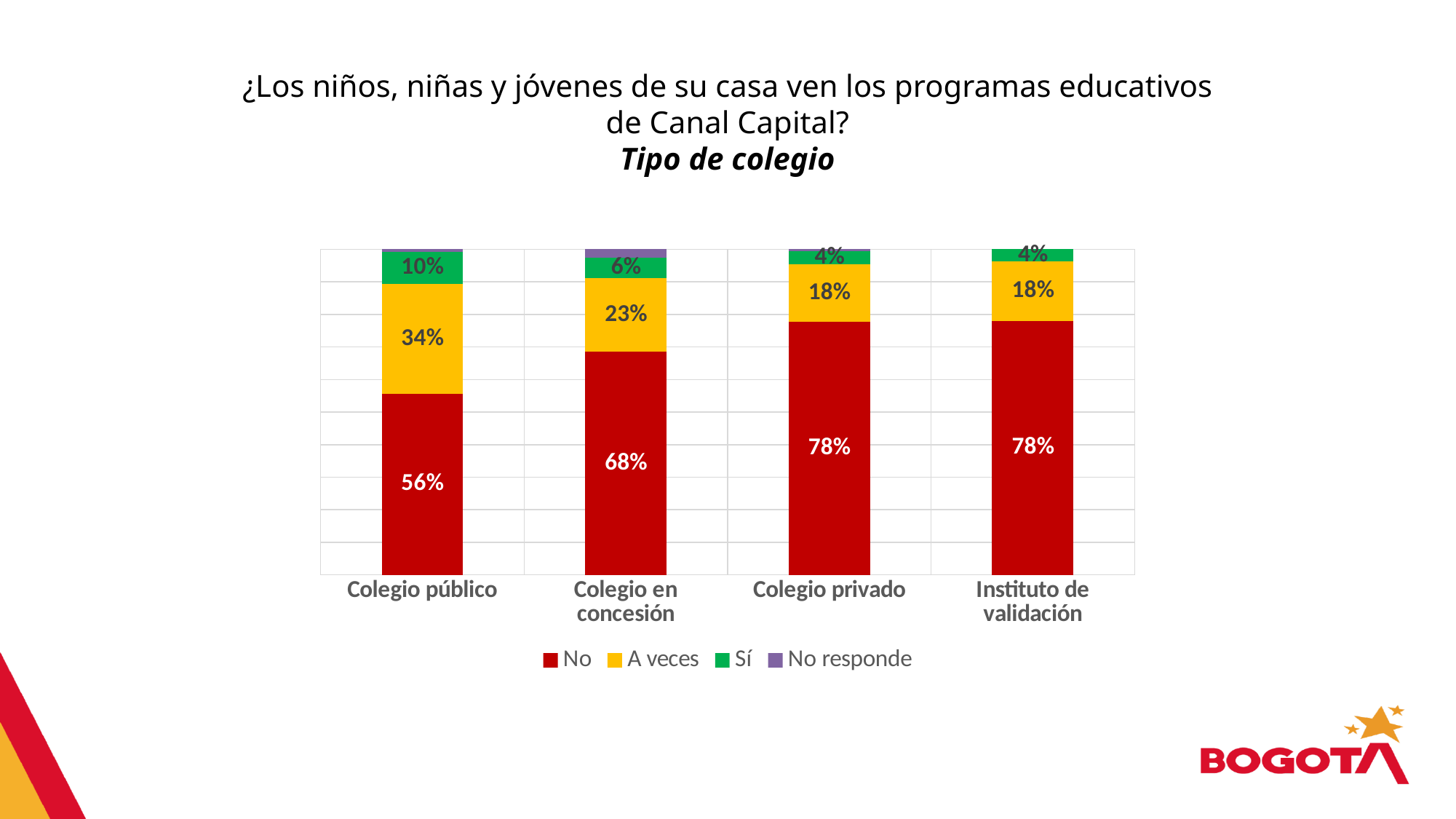
Which colour represents the "A veces" series in the legend? Yellow Which school type has the lowest "No" percentage? Colegio público Which is larger, the "A veces" value for Colegio público or for Colegio privado? Colegio público What is the "Sí" value for Colegio privado? 4% What is the "No" value for Instituto de validación? 78% What is the difference between the "No" values for Colegio en concesión and Colegio público? 12% Which school type has the highest "Sí" percentage? Colegio público What is the "A veces" value for Colegio en concesión? 23% How many series does the legend list? 4 How many school types are shown on the x axis? 4 What percentage of Colegio público respondents answered "No"? 56% What kind of chart is shown on the slide? Stacked bar chart